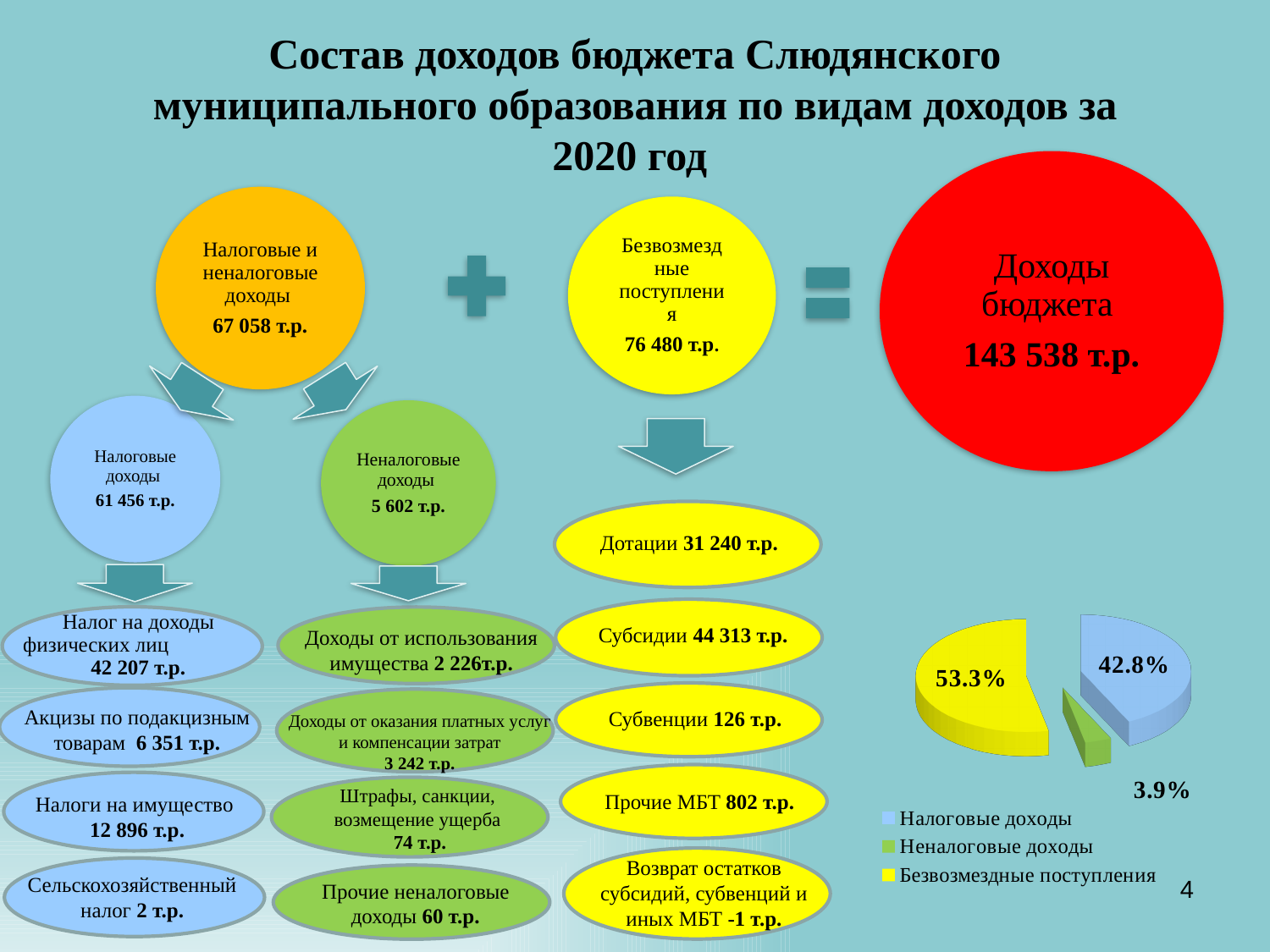
In the pie chart, what share is shown for Налоговые доходы? 42.8% How many slices does the pie chart have? 3 Which category has the largest slice in the pie chart? Безвозмездные поступления What colour is the Безвозмездные поступления slice in the pie chart? yellow In the pie chart, what is the difference between the shares of Налоговые доходы and Неналоговые доходы? 38.9% Which category has the smallest slice in the pie chart? Неналоговые доходы In the pie chart, which is larger: Налоговые доходы or Безвозмездные поступления? Безвозмездные поступления In the pie chart, what is the difference between the shares of Безвозмездные поступления and Налоговые доходы? 10.5% In the pie chart, what share is shown for Безвозмездные поступления? 53.3% In the pie chart, what share is shown for Неналоговые доходы? 3.9% How many entries does the pie chart's legend list? 3 What kind of chart is shown in the bottom right of the slide? pie chart